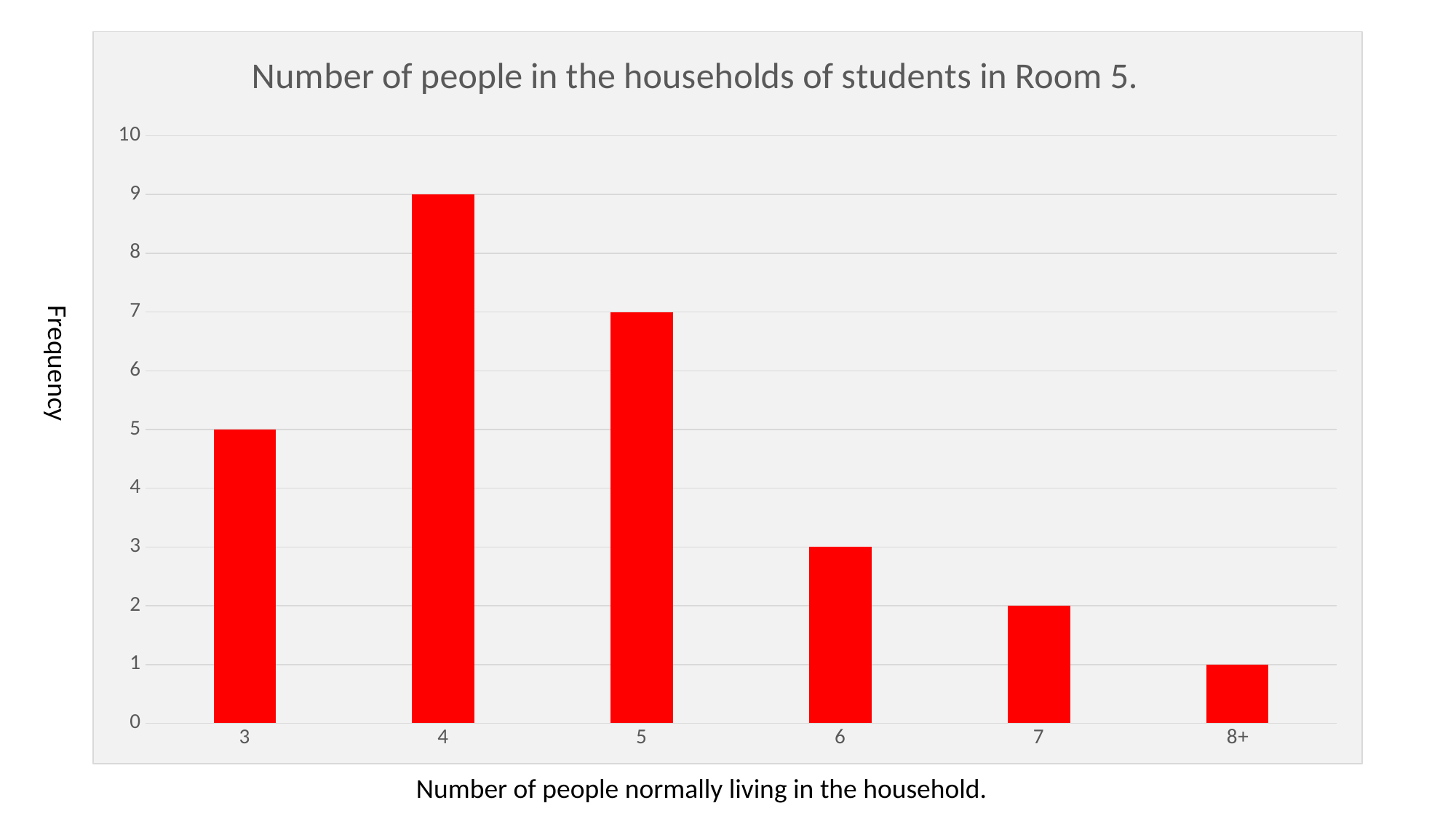
Do the frequencies rise or fall from household size 4 to household size 8+? fall Which has a higher frequency: households with 3 people or households with 6 people? 3 How many household-size categories are shown on the x axis? 6 What is the frequency for households with 3 people? 5 Which household size has the highest frequency? 4 What is the frequency for households with 4 people? 9 What kind of chart is shown on the slide? bar chart Is the frequency for households with 5 people greater or less than 6? greater What is the frequency for households with 8+ people? 1 What is the difference in frequency between households of 4 people and households of 5 people? 2 Which household size has the lowest frequency? 8+ What is the title of the chart? Number of people in the households of students in Room 5.